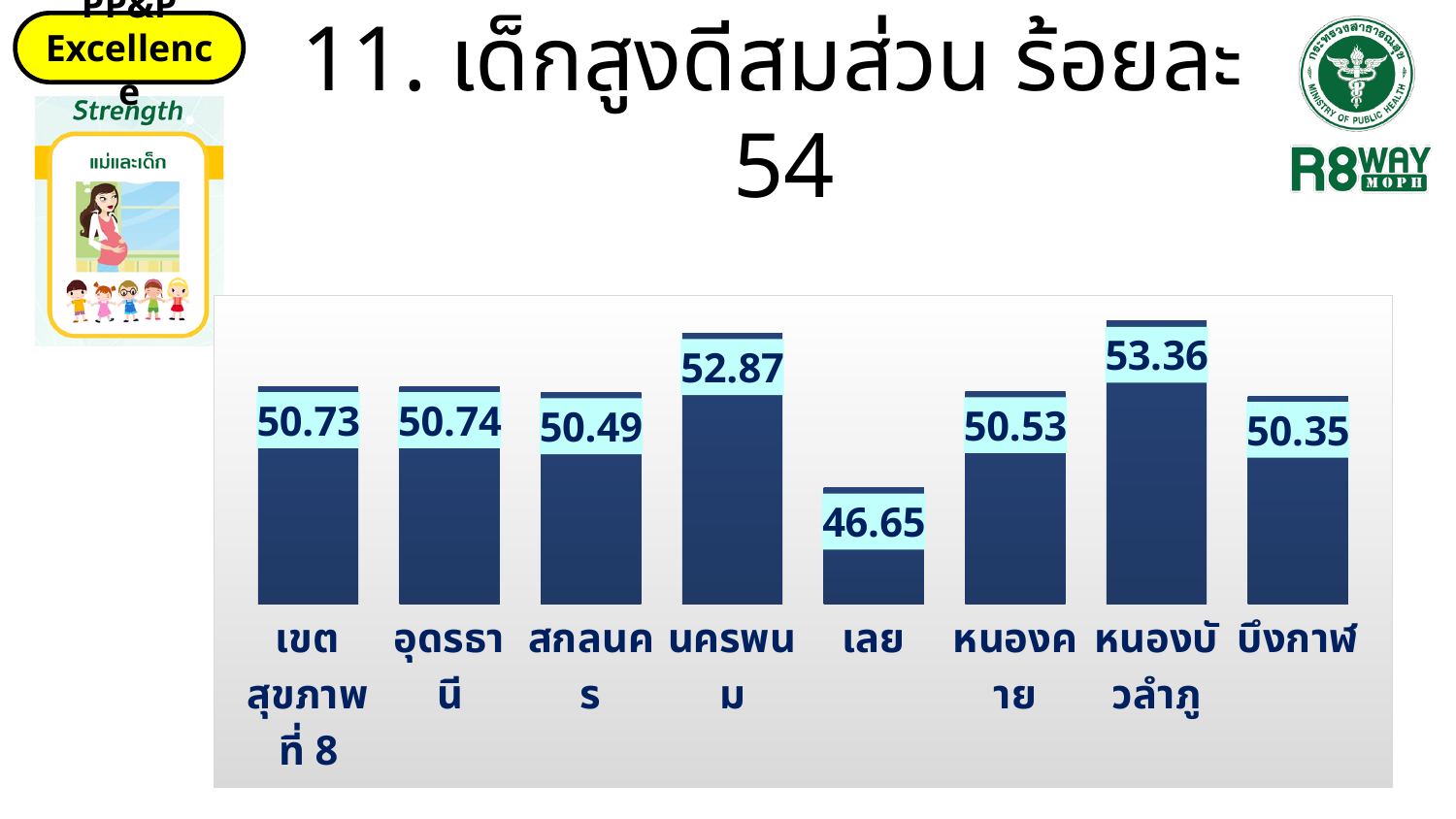
How many categories are shown in the chart? 8 What is the value for เลย? 46.65 Which province has the lowest value? เลย What is the difference between the values for นครพนม and บึงกาฬ? 2.52 What is the difference between the values for หนองบัวลำภู and เลย? 6.71 What is the value for นครพนม? 52.87 What is the target percentage stated in the slide title? ร้อยละ 54 What is the value for เขตสุขภาพที่ 8? 50.73 What kind of chart is shown on the slide? bar chart Which province has the highest value? หนองบัวลำภู Which is larger, the value for นครพนม or the value for หนองคาย? นครพนม What is the value for หนองบัวลำภู? 53.36